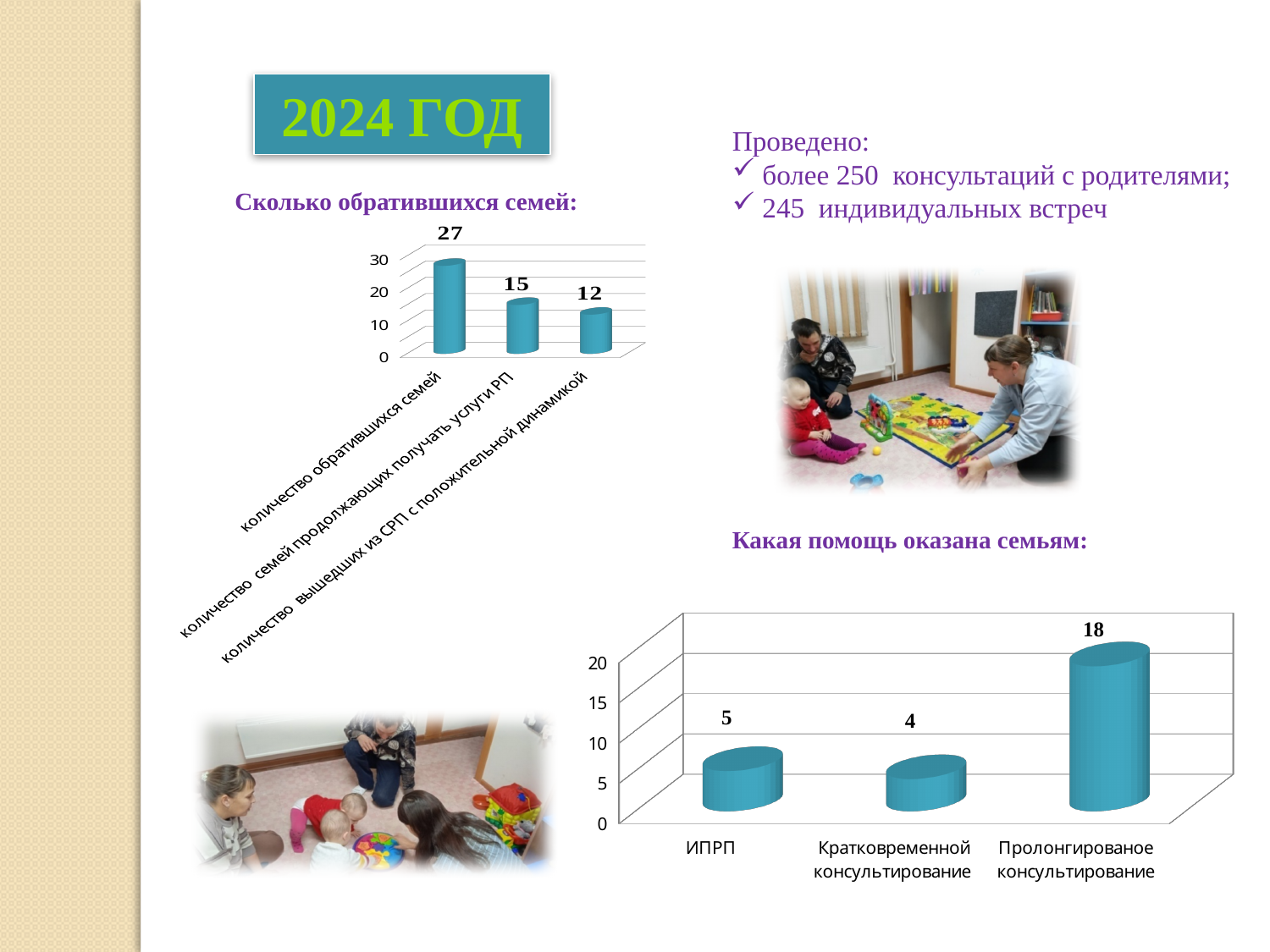
In the chart 'Сколько обратившихся семей:', do the values rise or fall from left to right? fall In the chart 'Какая помощь оказана семьям:', what is the value for 'ИПРП'? 5 In the chart 'Сколько обратившихся семей:', what is the value for 'количество вышедших из СРП с положительной динамикой'? 12 In the chart 'Какая помощь оказана семьям:', what is the value for 'Пролонгированое консультирование'? 18 In the chart 'Сколько обратившихся семей:', which category has the lowest value? количество вышедших из СРП с положительной динамикой In the chart 'Сколько обратившихся семей:', what is the value for 'количество обратившихся семей'? 27 In the chart 'Сколько обратившихся семей:', what is the value for 'количество семей продолжающих получать услуги РП'? 15 What kind of chart is 'Какая помощь оказана семьям:'? bar chart In the chart 'Сколько обратившихся семей:', what is the difference between 'количество обратившихся семей' and 'количество семей продолжающих получать услуги РП'? 12 In the chart 'Сколько обратившихся семей:', how many categories are shown? 3 In the chart 'Какая помощь оказана семьям:', which is larger: 'ИПРП' or 'Кратковременной консультирование'? ИПРП In the chart 'Какая помощь оказана семьям:', which category has the highest value? Пролонгированое консультирование